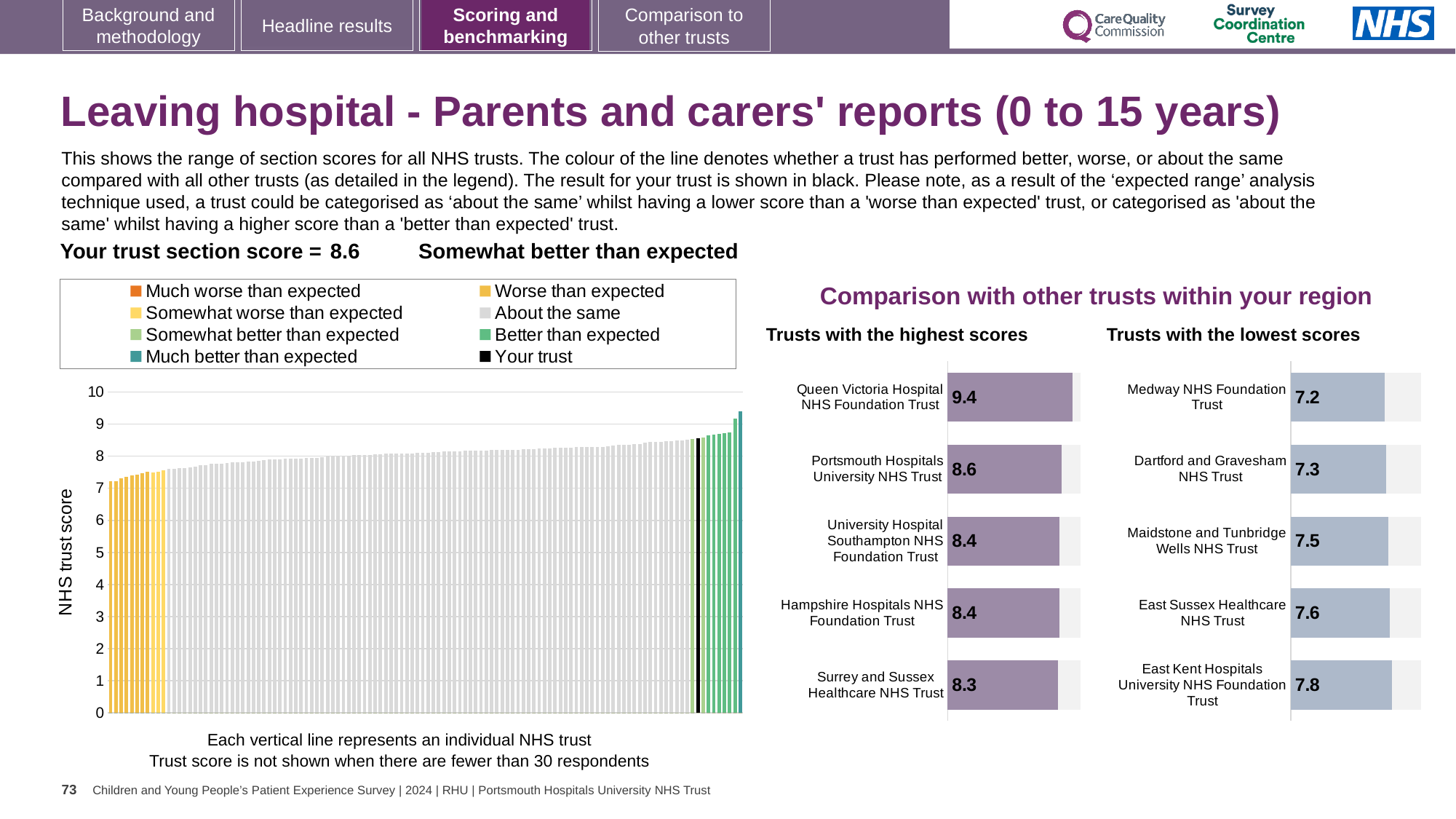
In the 'Trusts with the lowest scores' chart, what is the difference between the scores of East Kent Hospitals University NHS Foundation Trust and Medway NHS Foundation Trust? 0.6 In the 'Trusts with the highest scores' chart, which trust has the highest score? Queen Victoria Hospital NHS Foundation Trust In the main 'NHS trust score' chart, do the values rise or fall from left to right? Rise How many trusts are shown in the 'Trusts with the highest scores' chart? 5 In the 'Trusts with the lowest scores' chart, what is the score for Medway NHS Foundation Trust? 7.2 How many entries does the legend of the main 'NHS trust score' chart list? 8 In the 'Trusts with the highest scores' chart, what is the difference between the scores of Queen Victoria Hospital NHS Foundation Trust and Surrey and Sussex Healthcare NHS Trust? 1.1 In the 'Trusts with the lowest scores' chart, which has the higher score: Dartford and Gravesham NHS Trust or East Sussex Healthcare NHS Trust? East Sussex Healthcare NHS Trust In the 'Trusts with the highest scores' chart, what is the score for Queen Victoria Hospital NHS Foundation Trust? 9.4 In the main 'NHS trust score' chart, what colour is used to show 'Your trust'? Black What kind of chart is the main chart on the left showing NHS trust scores? Bar chart In the 'Trusts with the lowest scores' chart, which trust has the lowest score? Medway NHS Foundation Trust